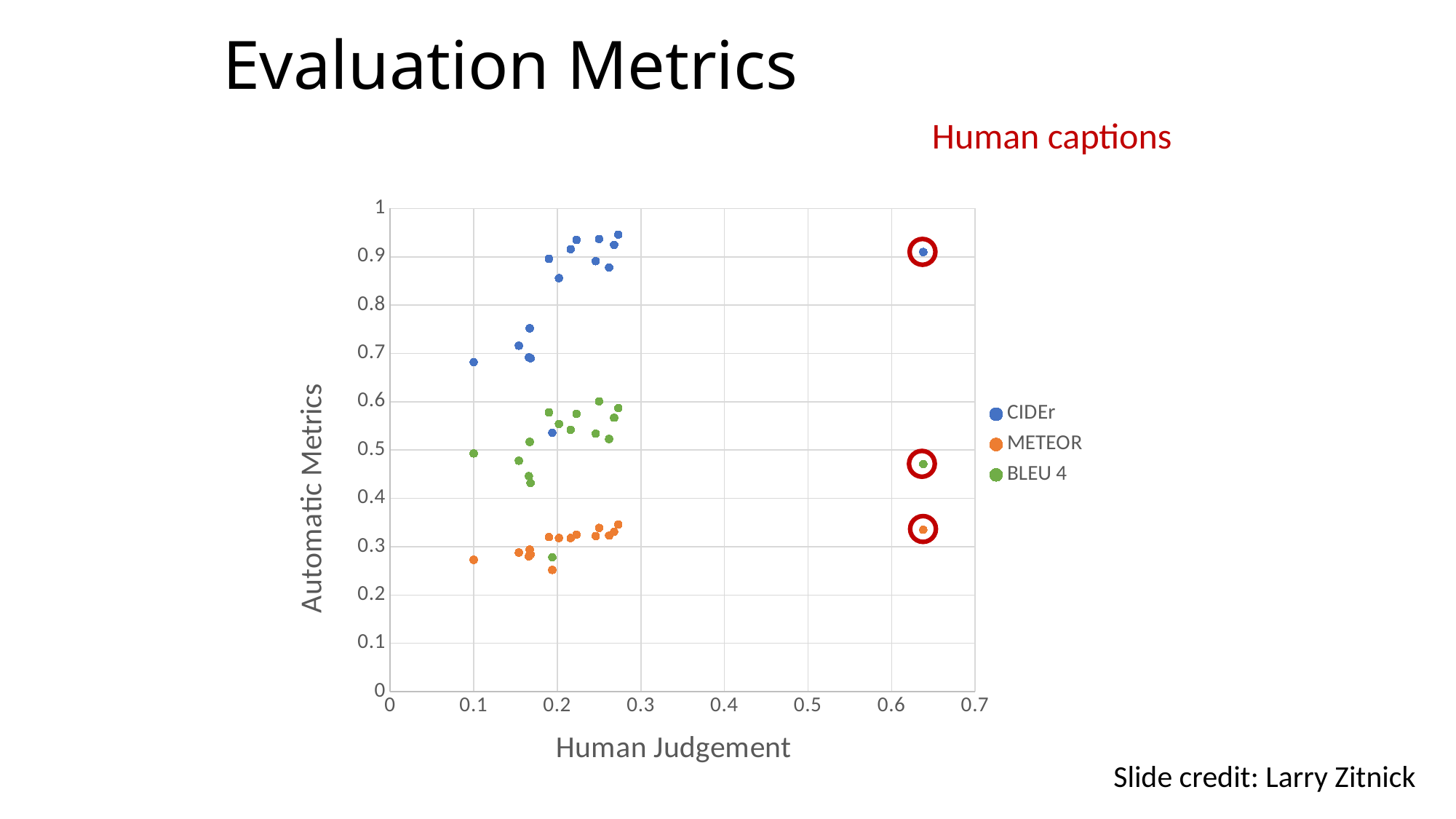
Which series has higher Automatic Metrics values, BLEU 4 or METEOR? BLEU 4 What is the label of the x axis of the chart? Human Judgement Do the CIDEr values generally rise or fall as Human Judgement increases? rise Which series has the highest Automatic Metrics values on the chart? CIDEr What kind of chart is shown on the slide? scatter chart Is the Automatic Metrics value of the circled CIDEr point for human captions greater or less than 0.8? greater Which series has the lowest Automatic Metrics values on the chart? METEOR Is the Automatic Metrics value of the circled METEOR point for human captions greater or less than 0.3? greater Is the Human Judgement value of the circled human-caption points greater or less than 0.6? greater What are the three series listed in the chart legend? CIDEr, METEOR, BLEU 4 How many series does the chart legend list? 3